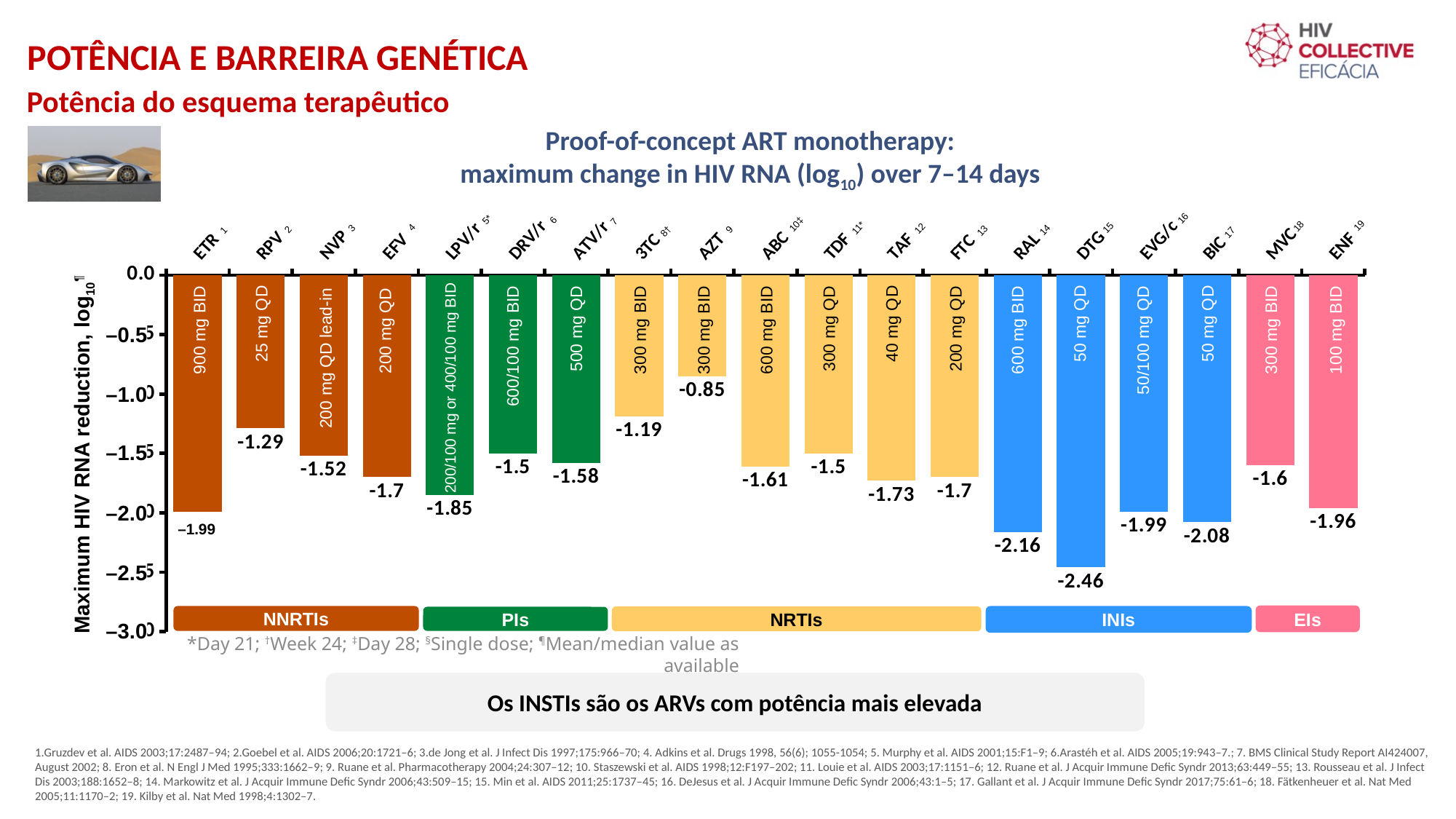
What is the difference between the values for DTG and RAL? 0.30 Which drug shows the largest maximum HIV RNA reduction (most negative value)? DTG Which drug shows the smallest maximum HIV RNA reduction (least negative value)? AZT How many drugs are plotted in the chart? 19 What is the maximum HIV RNA reduction value shown for DTG? -2.46 Which drug has a larger HIV RNA reduction, BIC or EVG/c? BIC What dose is printed on the bar for DTG? 50 mg QD What kind of chart is shown on the slide? Bar chart What is the value shown for RAL? -2.16 What is the value shown for ETR? -1.99 What is the value shown for AZT? -0.85 How many drug classes are labelled along the bottom of the chart? 5